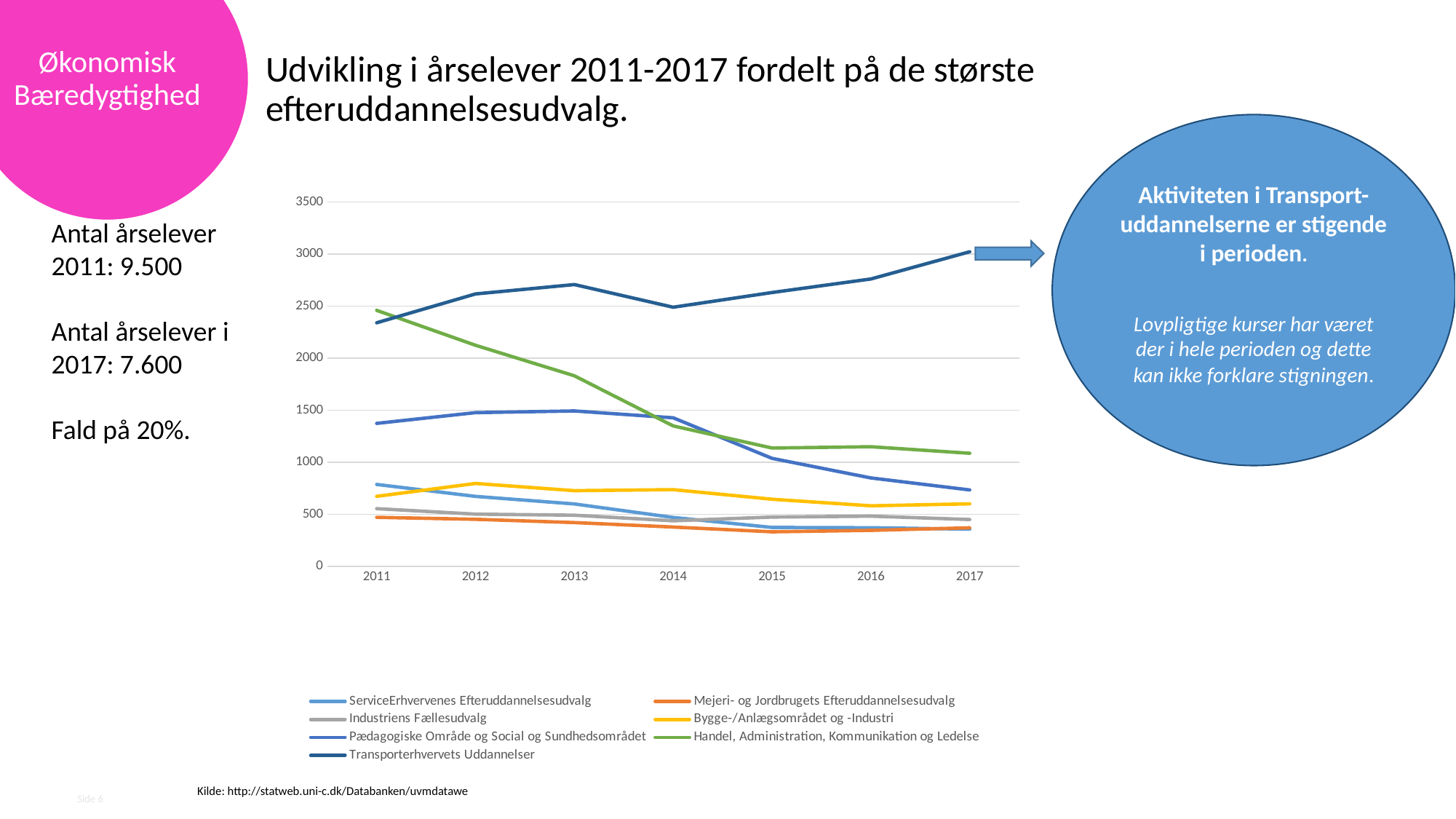
How many years are shown along the x axis of the chart? 7 Does the value for Handel, Administration, Kommunikation og Ledelse rise or fall from 2011 to 2017? Fall What kind of chart is shown on the slide? Line chart Is the value for Handel, Administration, Kommunikation og Ledelse in 2011 greater or less than 2000? greater Is the value for Transporterhvervets Uddannelser in 2017 greater or less than 2500? greater How many series does the chart's legend list? 7 Which series is drawn in green on the chart? Handel, Administration, Kommunikation og Ledelse In 2017, which is larger: Handel, Administration, Kommunikation og Ledelse or Pædagogiske Område og Social og Sundhedsområdet? Handel, Administration, Kommunikation og Ledelse Does the value for Transporterhvervets Uddannelser rise or fall from 2011 to 2017? Rise Is the value for Pædagogiske Område og Social og Sundhedsområdet in 2017 greater or less than 1000? less Which series has the highest value in 2017? Transporterhvervets Uddannelser